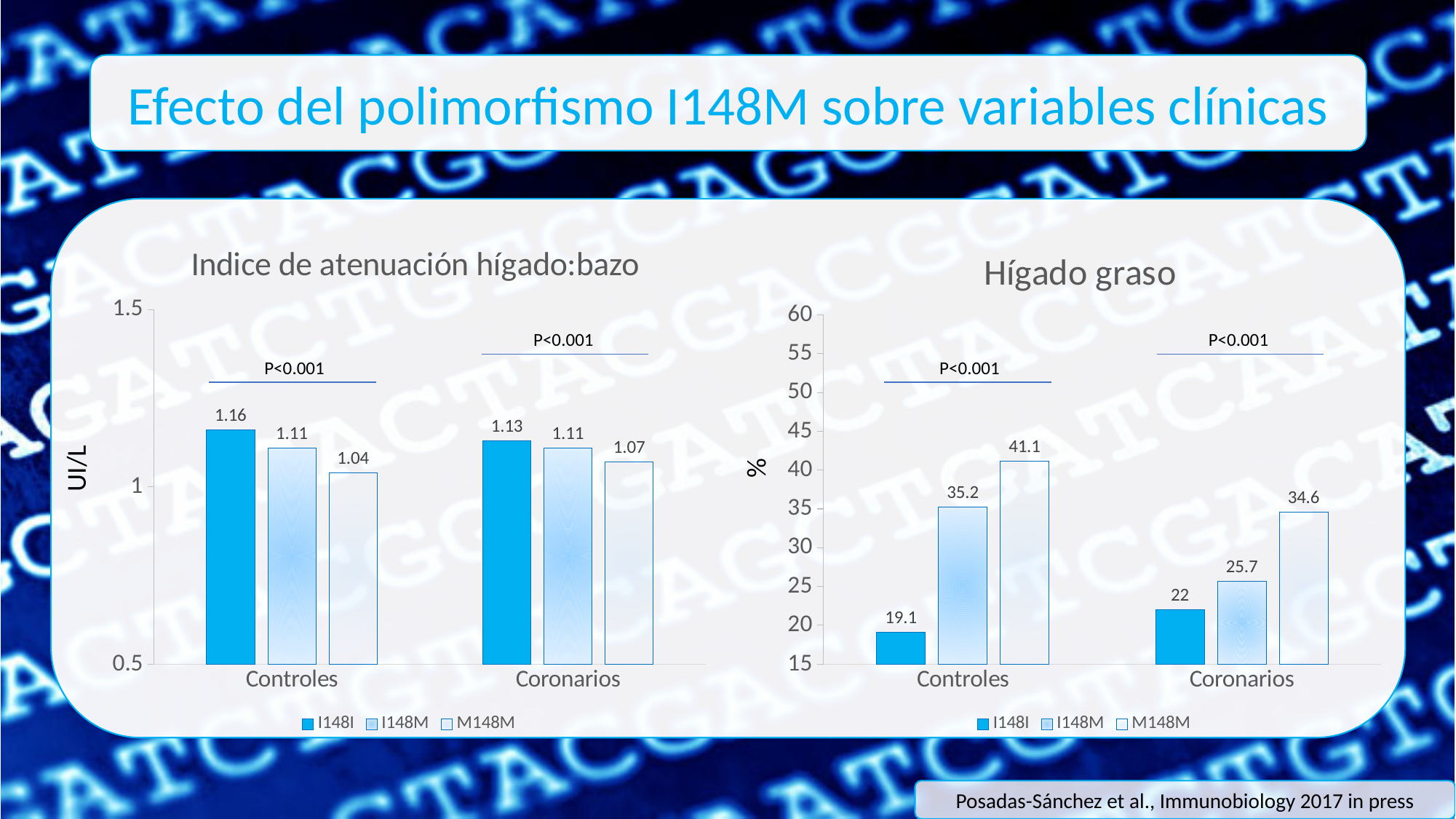
In the 'Hígado graso' chart, is the M148M value for Controles or for Coronarios larger? Controles What kind of chart is the 'Indice de atenuación hígado:bazo' chart? bar chart In the 'Indice de atenuación hígado:bazo' chart, what is the value for M148M in the Coronarios group? 1.07 In the 'Hígado graso' chart, what is the value for I148I in the Coronarios group? 22 In the 'Hígado graso' chart, what is the difference between the M148M and I148I values in the Controles group? 22 In the 'Hígado graso' chart, which genotype has the highest value in the Controles group? M148M In the 'Hígado graso' chart, what is the value for I148M in the Controles group? 35.2 In the 'Indice de atenuación hígado:bazo' chart, what is the difference between the I148I and M148M values in the Coronarios group? 0.06 In the 'Indice de atenuación hígado:bazo' chart, what is the value for I148I in the Controles group? 1.16 In the 'Indice de atenuación hígado:bazo' chart, which genotype has the lowest value in the Controles group? M148M What is the y-axis label of the 'Indice de atenuación hígado:bazo' chart? UI/L How many series does the legend of the 'Hígado graso' chart list? 3